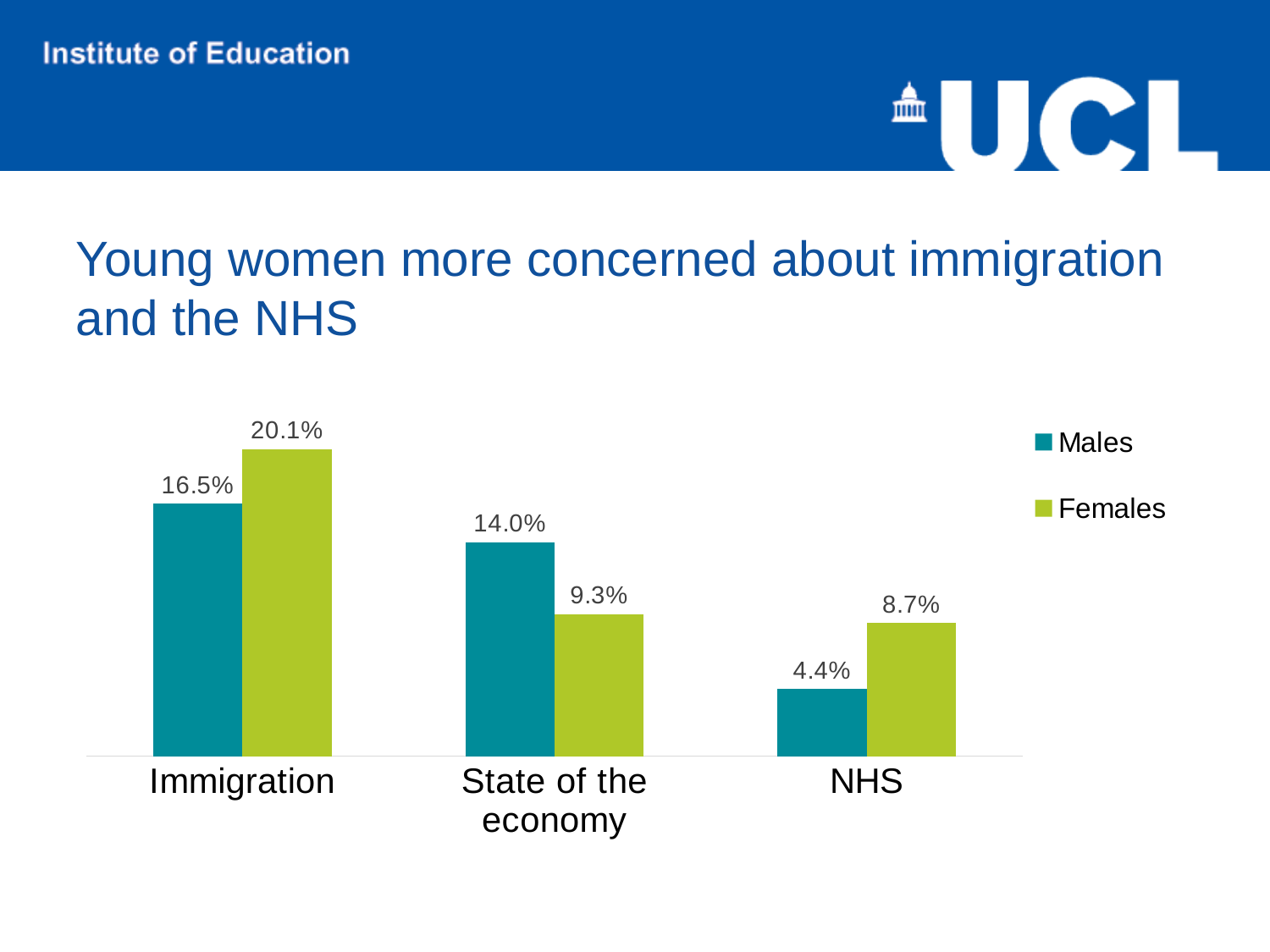
What kind of chart is shown on the slide? Bar chart How many series does the legend list? 2 What is the value for Females for NHS? 8.7% What is the difference between the Females and Males values for Immigration? 3.6% How many categories are shown on the x axis? 3 What is the value for Females for Immigration? 20.1% Which is larger for NHS, the Males value or the Females value? Females What is the difference between the Males and Females values for State of the economy? 4.7% Which category has the highest value for Males? Immigration Which category has the lowest value for Females? NHS What is the value for Males for NHS? 4.4% What is the value for Males for State of the economy? 14.0%